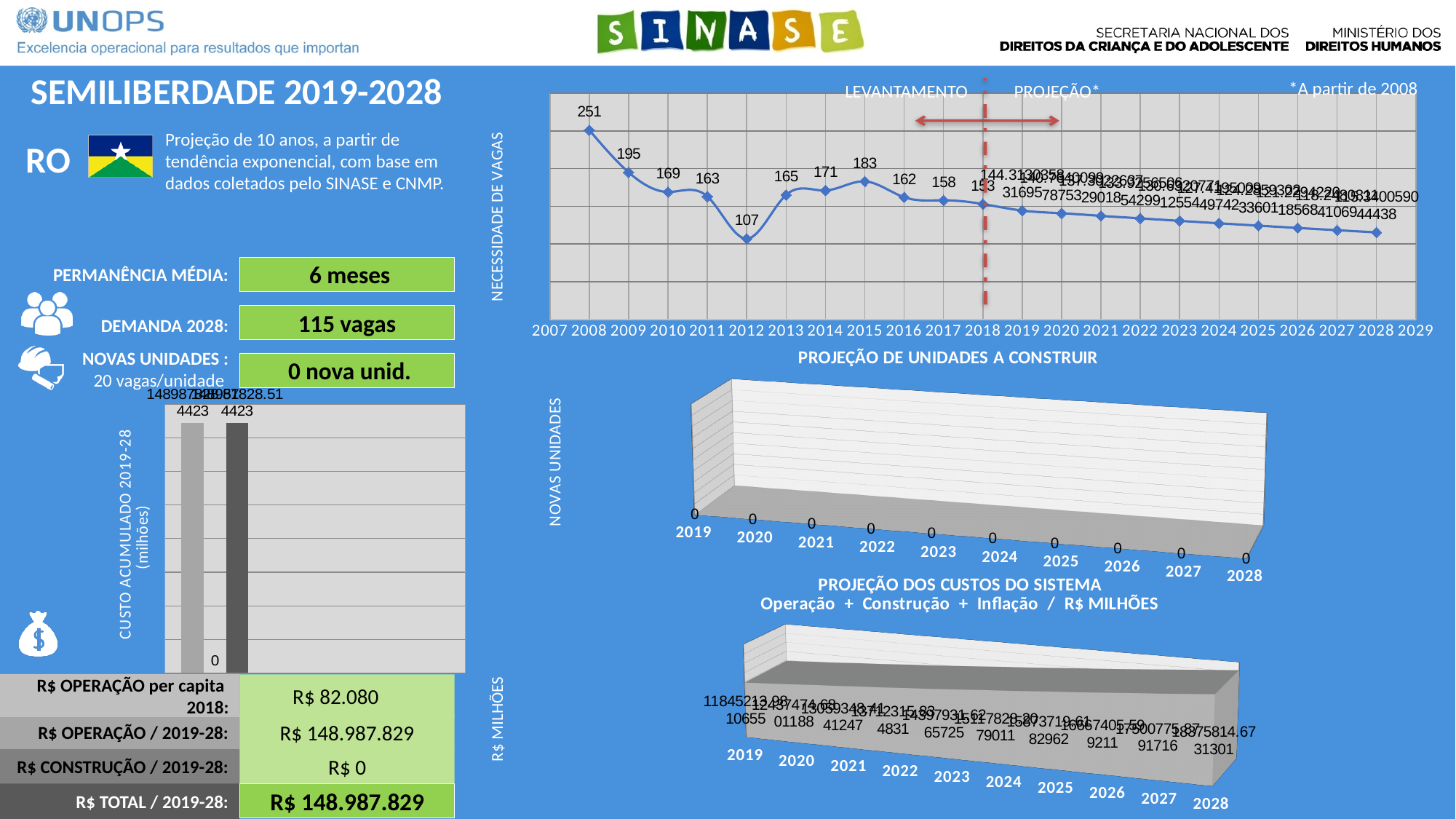
In the line chart labelled NECESSIDADE DE VAGAS, what is the difference between the values for 2008 and 2009? 56 In the chart titled PROJEÇÃO DE UNIDADES A CONSTRUIR, what is the value for 2019? 0 In the line chart labelled NECESSIDADE DE VAGAS, what is the value for 2018? 153 What kind of chart is the chart labelled NECESSIDADE DE VAGAS at the top right? line chart In the line chart labelled NECESSIDADE DE VAGAS, which year has the larger value, 2014 or 2016? 2014 In the line chart labelled NECESSIDADE DE VAGAS, which year has the lowest value? 2012 How many years are shown on the x axis of the chart titled PROJEÇÃO DE UNIDADES A CONSTRUIR? 10 What kind of chart is the chart titled PROJEÇÃO DOS CUSTOS DO SISTEMA? area chart In the line chart labelled NECESSIDADE DE VAGAS, do the values rise or fall from 2018 to 2028? fall In the line chart labelled NECESSIDADE DE VAGAS, which year has the highest value? 2008 In the line chart labelled NECESSIDADE DE VAGAS, what is the value for 2012? 107 In the line chart labelled NECESSIDADE DE VAGAS, what is the value for 2008? 251